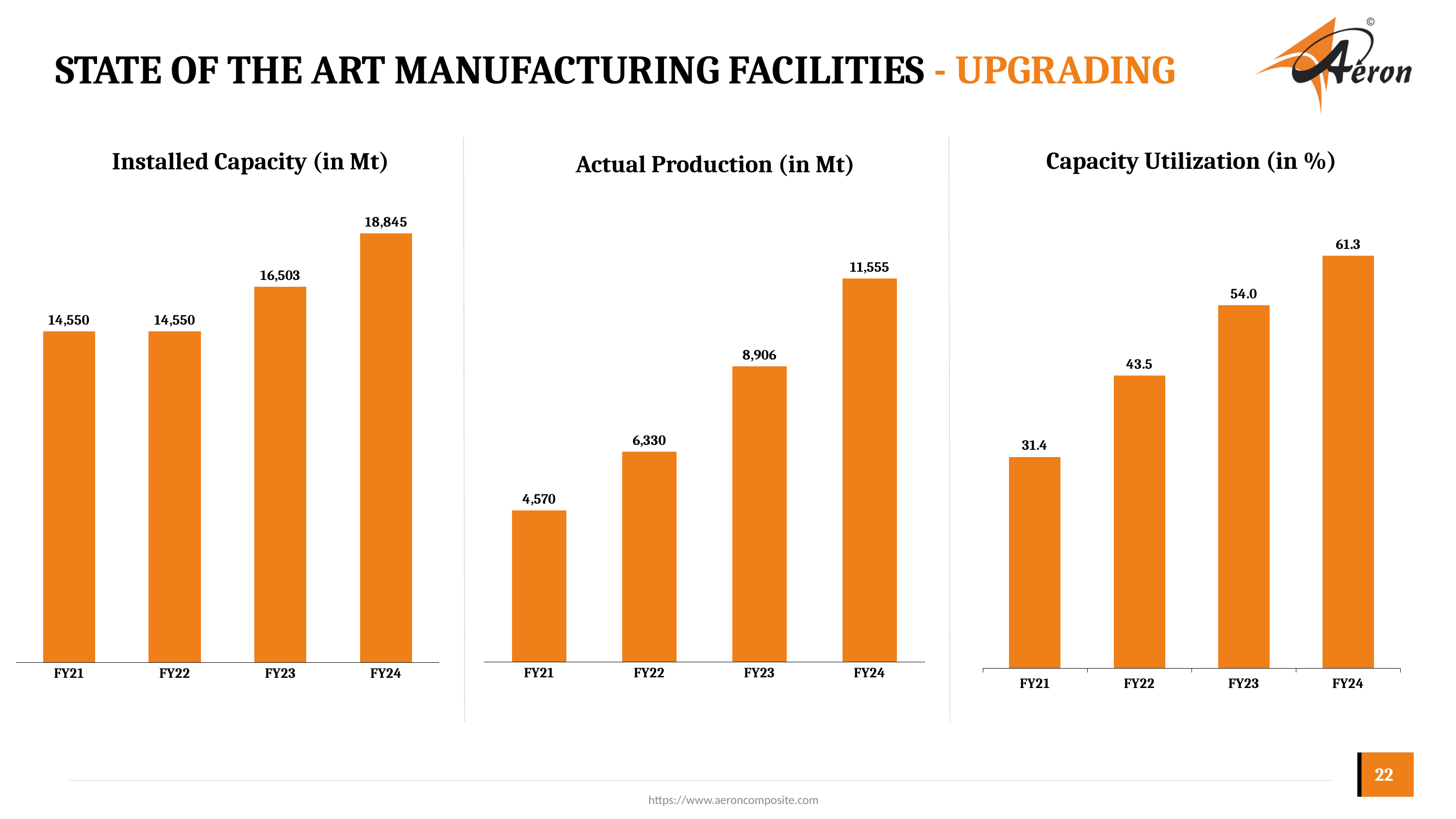
In the Actual Production (in Mt) chart, what is the difference between the FY23 and FY21 values? 4,336 What kind of chart is the Capacity Utilization (in %) chart? Bar chart In the Actual Production (in Mt) chart, which fiscal year has the highest value? FY24 In the Installed Capacity (in Mt) chart, what is the difference between the FY24 and FY23 values? 2,342 In the Capacity Utilization (in %) chart, which fiscal year has the lowest value? FY21 In the Capacity Utilization (in %) chart, which is larger, the FY22 value or the FY23 value? FY23 How many charts are shown on the slide? 3 How many fiscal years are shown in the Actual Production (in Mt) chart? 4 In the Actual Production (in Mt) chart, do the values rise or fall from FY21 to FY24? Rise In the Actual Production (in Mt) chart, what is the value for FY22? 6,330 In the Installed Capacity (in Mt) chart, what is the value for FY24? 18,845 In the Capacity Utilization (in %) chart, what is the value for FY21? 31.4